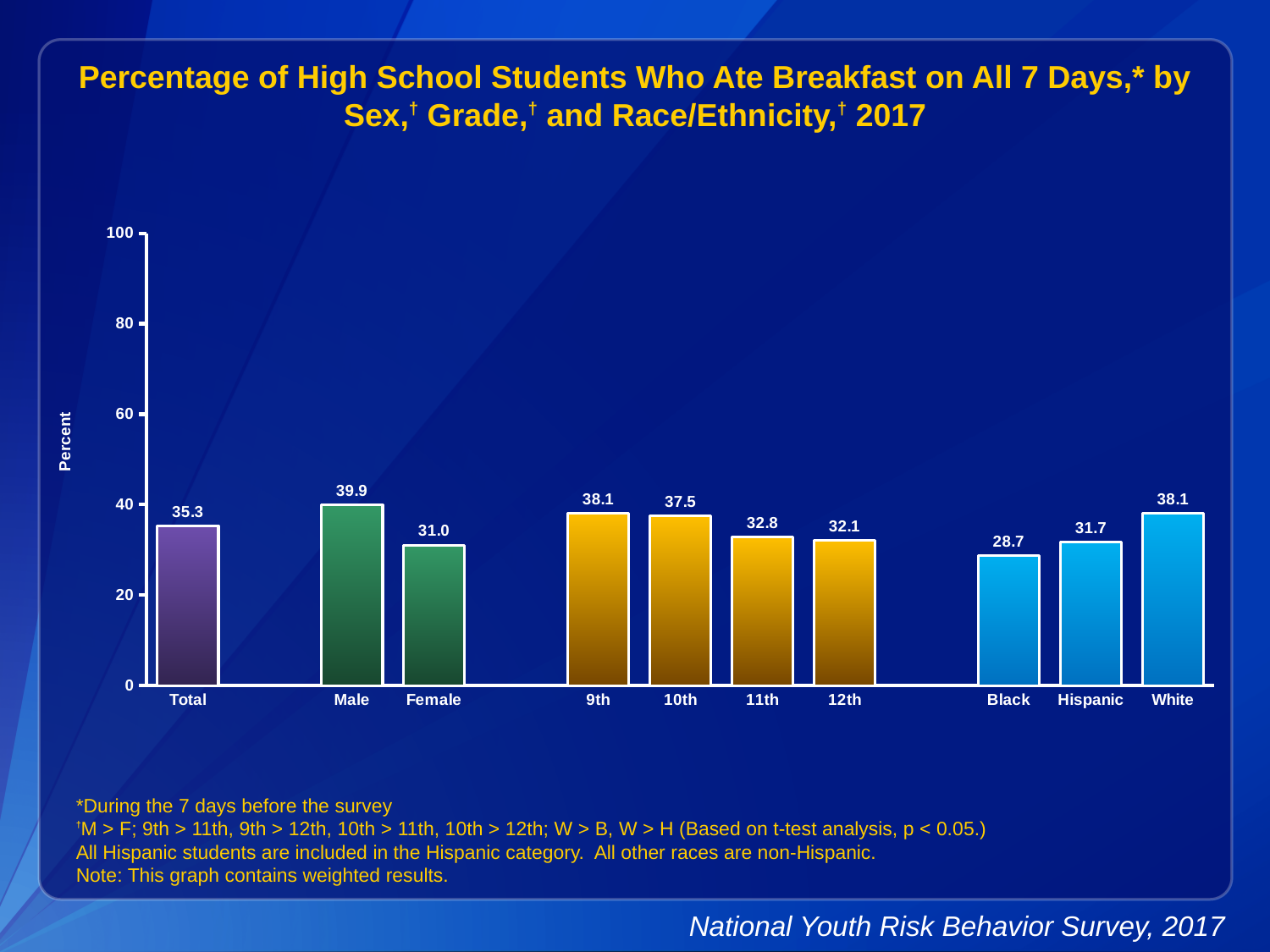
What kind of chart is shown on the slide? Bar chart What is the difference between the Male and Female values? 8.9 What is the label on the y axis? Percent What is the value for 11th grade? 32.8 What is the difference between the 9th and 12th grade values? 6.0 Which category has the lowest value? Black How many bars are shown in the chart? 10 What is the value for Female? 31.0 What is the value for Total? 35.3 What is the value for Hispanic? 31.7 Which category has the highest value? Male Which is larger, the value for White or the value for Black? White